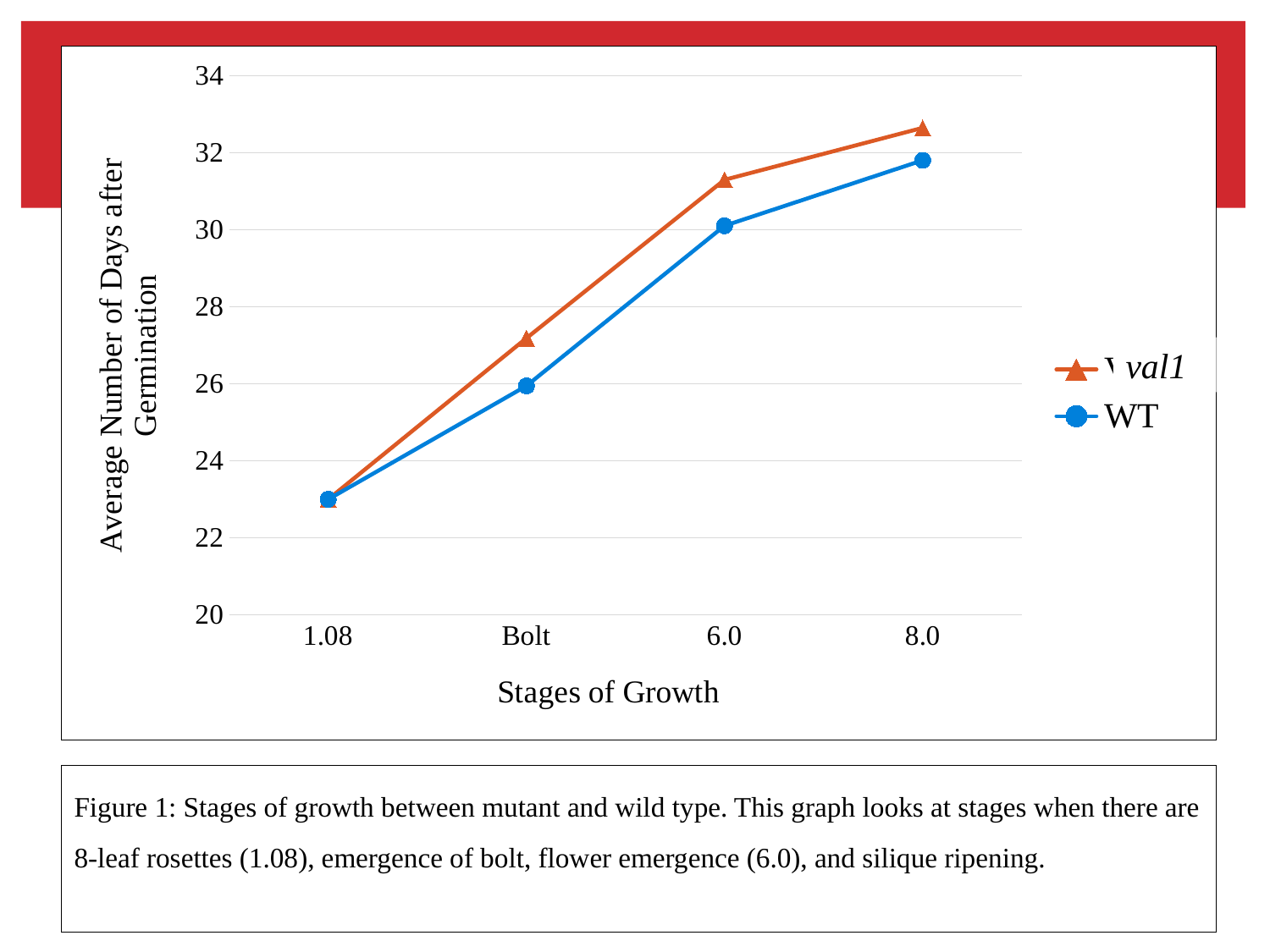
Is the value for val1 at stage 6.0 greater or less than 30? greater What kind of chart is shown on the slide? line chart Is the value for WT at stage 1.08 greater or less than 24? less Is the value for val1 at stage 8.0 greater or less than 32? greater At which stage of growth is the value for WT lowest? 1.08 At the Bolt stage, which series has the larger value, val1 or WT? val1 Do the values for WT rise or fall from stage 1.08 to stage 8.0? rise How many series does the legend list? 2 How many stages of growth are plotted along the x axis? 4 At stage 6.0, which series has the larger value, val1 or WT? val1 What is the title of the x axis? Stages of Growth At which stage of growth is the value for val1 highest? 8.0